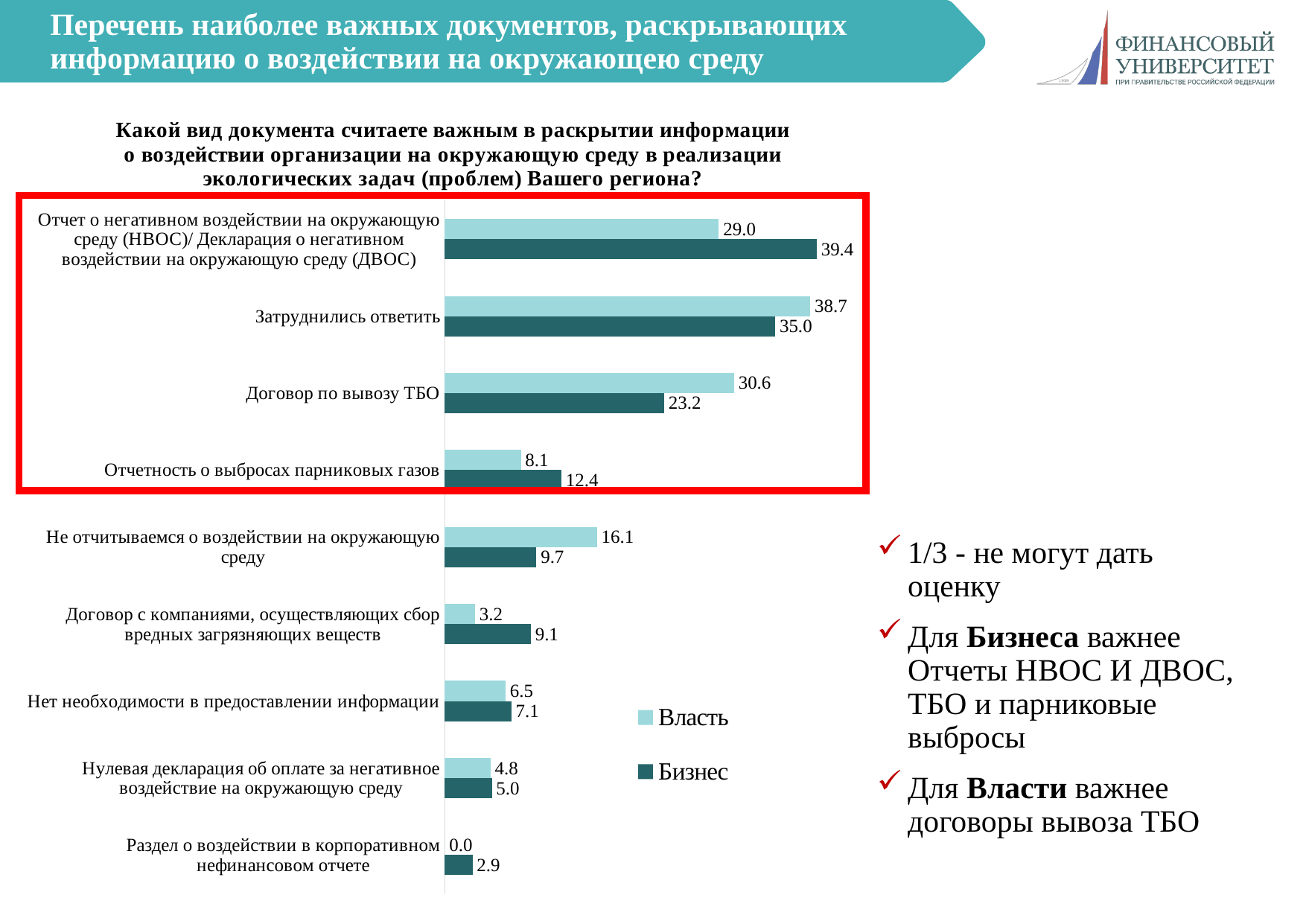
What type of chart is shown on the slide? bar chart How many series does the legend list? 2 How many categories (document types) are shown in the chart? 9 What is the value for Бизнес for "Договор по вывозу ТБО"? 23.2 Which category has the highest value for Бизнес? Отчет о негативном воздействии на окружающую среду (НВОС)/ Декларация о негативном воздействии на окружающую среду (ДВОС) What is the value for Власть for "Раздел о воздействии в корпоративном нефинансовом отчете"? 0.0 What is the value for Бизнес for "Отчет о негативном воздействии на окружающую среду (НВОС)/ Декларация о негативном воздействии на окружающую среду (ДВОС)"? 39.4 For "Договор по вывозу ТБО", which series has the larger value, Власть or Бизнес? Власть Which category has the lowest value for Власть? Раздел о воздействии в корпоративном нефинансовом отчете What is the difference between the Бизнес and Власть values for "Отчетность о выбросах парниковых газов"? 4.3 What is the value for Власть for "Затруднились ответить"? 38.7 Which series is shown in the darker teal colour? Бизнес